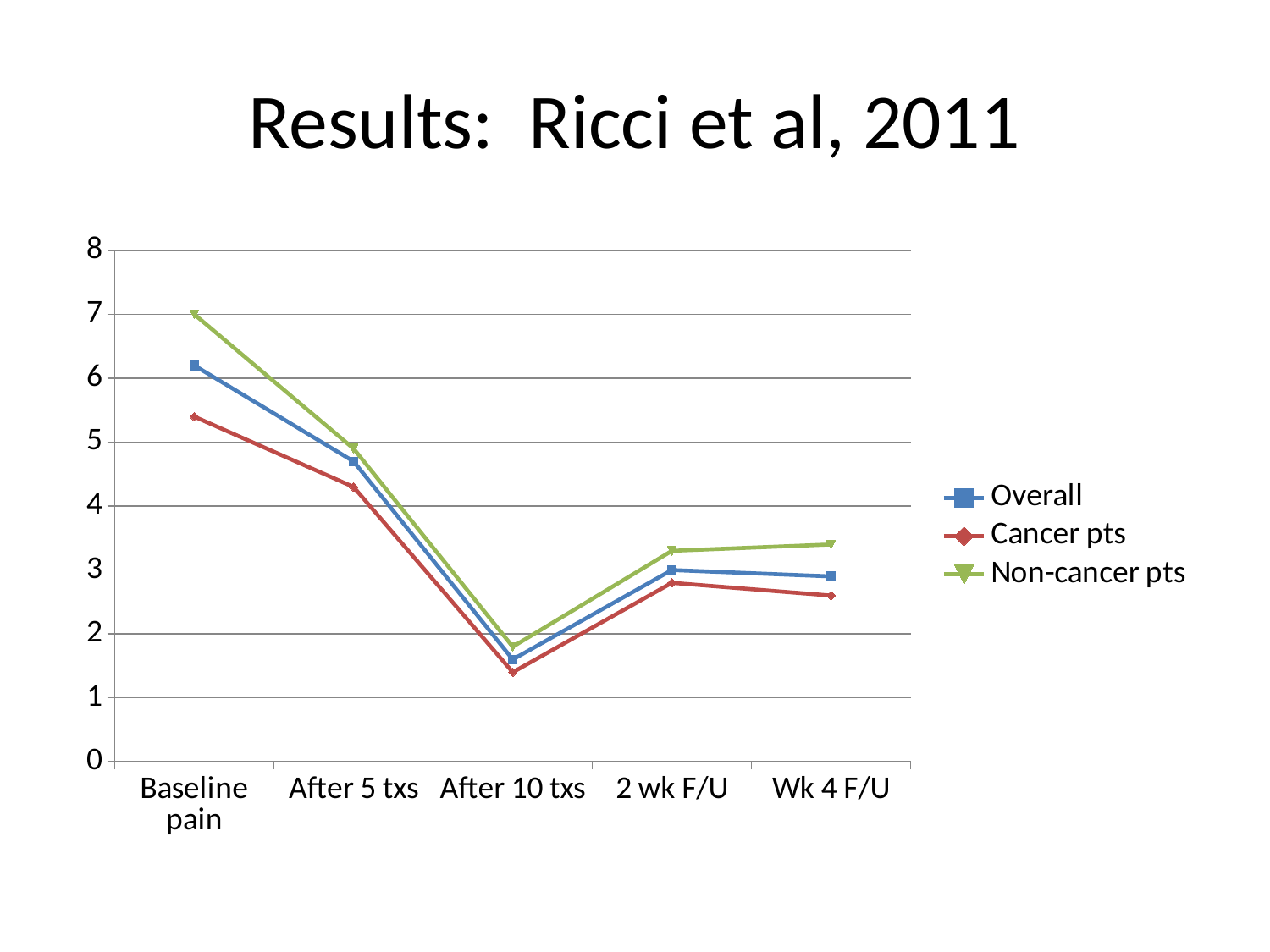
At which category does the Overall series reach its lowest value? After 10 txs Which series has the highest value at Baseline pain? Non-cancer pts Do the values for the Overall series rise or fall from Baseline pain to After 10 txs? fall What kind of chart is shown on the slide? line chart How many series does the legend list? 3 Is the value for Cancer pts at Baseline pain greater or less than 5? greater Is the value for Non-cancer pts at After 5 txs greater or less than 4? greater Which is larger at Wk 4 F/U: the Overall value or the Cancer pts value? Overall At which category does the Cancer pts series reach its highest value? Baseline pain How many categories are shown along the x axis? 5 Is the value for Overall at After 10 txs greater or less than 2? less Which series has the lowest value at After 10 txs? Cancer pts